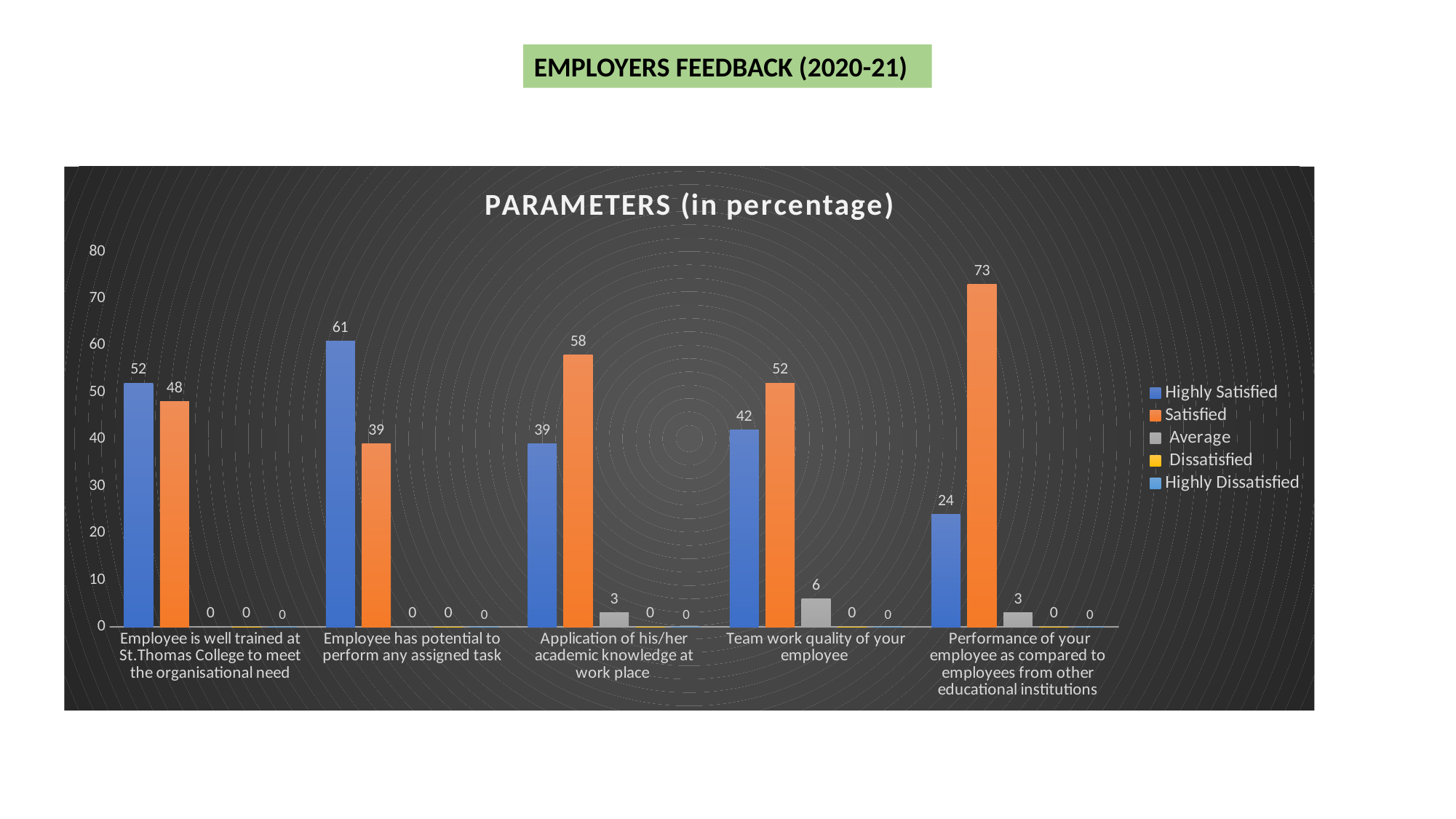
How many categories are shown on the x axis? 5 What is the Highly Satisfied value for "Employee has potential to perform any assigned task"? 61 What is the difference between the Satisfied and Highly Satisfied values for "Application of his/her academic knowledge at work place"? 19 What is the Satisfied value for "Performance of your employee as compared to employees from other educational institutions"? 73 What is the Average value for "Team work quality of your employee"? 6 For "Employee is well trained at St.Thomas College to meet the organisational need", which is larger: Highly Satisfied or Satisfied? Highly Satisfied How many series does the legend list? 5 What is the Dissatisfied value for "Team work quality of your employee"? 0 Which category has the highest Satisfied value? Performance of your employee as compared to employees from other educational institutions What is the title of the chart? PARAMETERS (in percentage) What kind of chart is shown on the slide? Bar chart Which category has the lowest Highly Satisfied value? Performance of your employee as compared to employees from other educational institutions